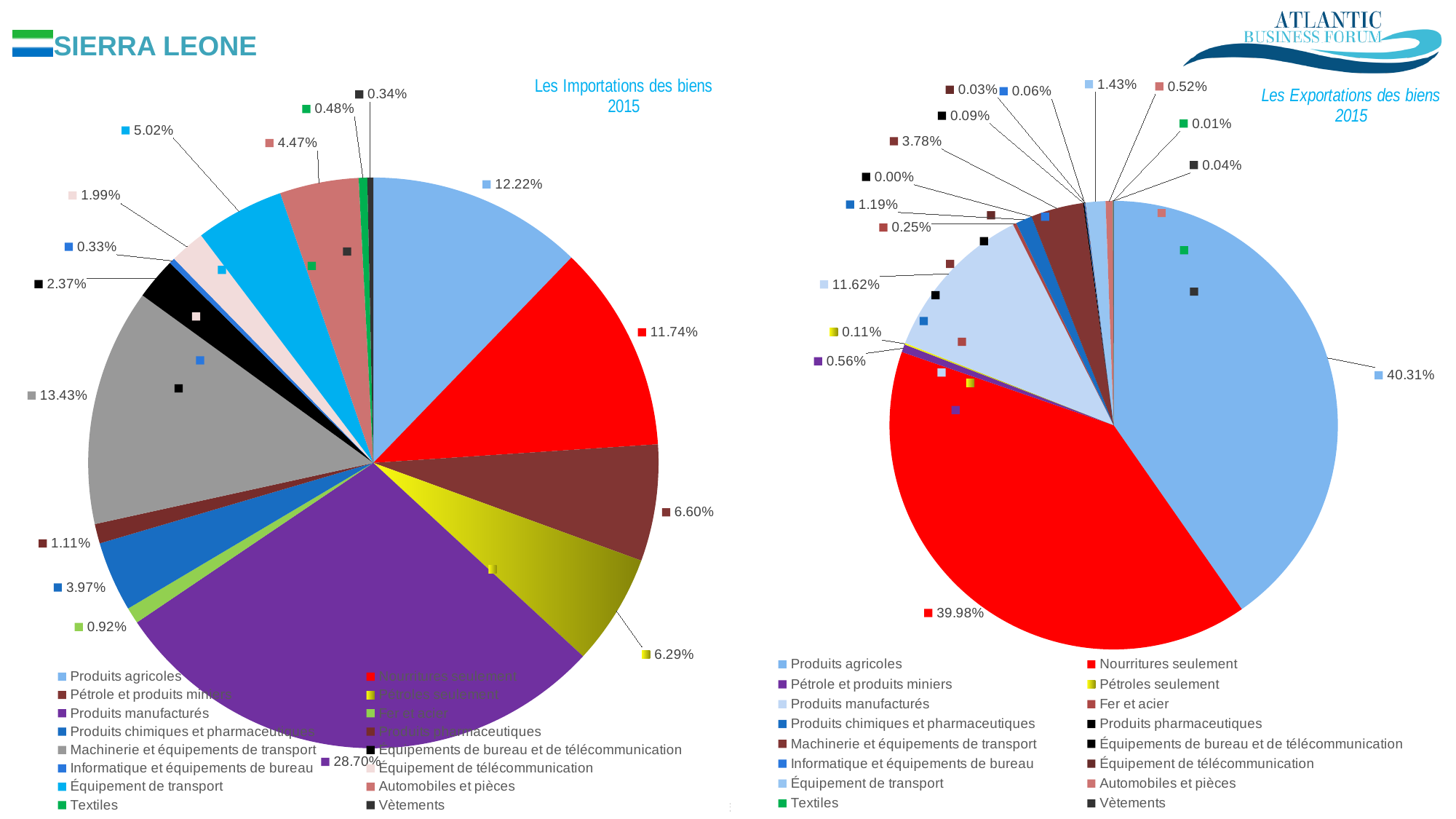
In the 'Les Importations des biens 2015' chart, which category has the largest share? Produits manufacturés In the 'Les Importations des biens 2015' chart, what is the share for Produits agricoles? 12.22% In the 'Les Exportations des biens 2015' chart, which is larger: Produits agricoles or Nourritures seulement? Produits agricoles In the 'Les Exportations des biens 2015' chart, what is the combined share of Produits agricoles (40.31%) and Nourritures seulement (39.98%)? 80.29% In the 'Les Importations des biens 2015' chart, what is the share for Machinerie et équipements de transport? 13.43% In the 'Les Importations des biens 2015' chart, what is the difference between the Produits agricoles share (12.22%) and the Nourritures seulement share (11.74%)? 0.48% In the 'Les Exportations des biens 2015' chart, what is the share for Produits agricoles? 40.31% In the 'Les Exportations des biens 2015' chart, what is the share for Nourritures seulement? 39.98% How many categories does the legend of the 'Les Exportations des biens 2015' chart list? 16 What type of chart is used for 'Les Importations des biens 2015'? Pie chart In the 'Les Importations des biens 2015' chart, what is the largest slice's share? 28.70% In the 'Les Exportations des biens 2015' chart, what is the share for Produits manufacturés? 11.62%